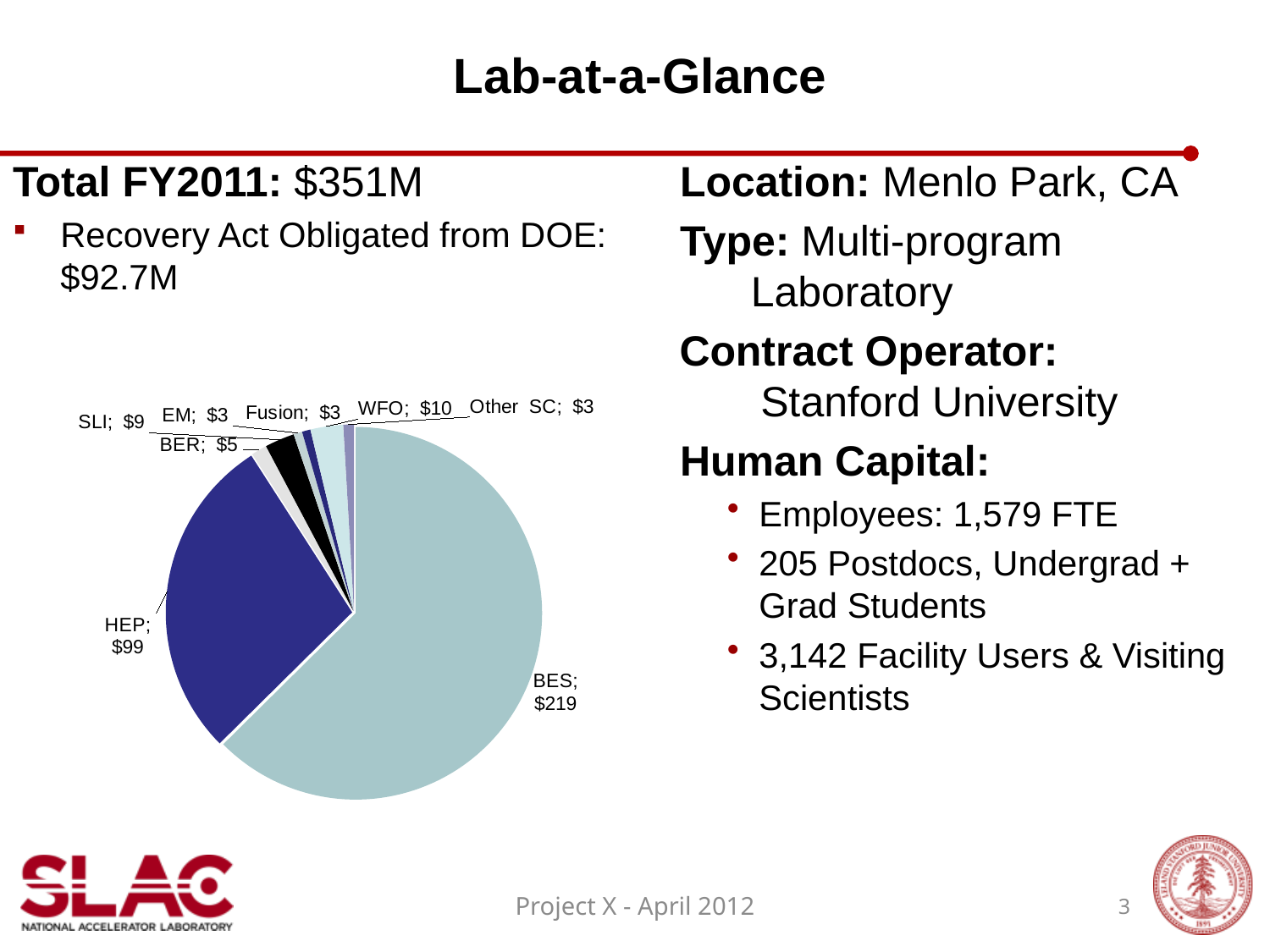
How many slices does the pie chart have? 8 What is the difference between the BES and HEP values in the pie chart? $120 What is the value for SLI in the pie chart? $9 Which category has the largest slice in the pie chart? BES What is the value for BES in the pie chart? $219 What kind of chart is shown on the slide? pie chart What is the total of all slices in the pie chart? $351 What is the difference between the WFO and BER values in the pie chart? $5 What is the value for WFO in the pie chart? $10 What is the value for BER in the pie chart? $5 Which is larger in the pie chart, WFO or SLI? WFO What is the value for HEP in the pie chart? $99